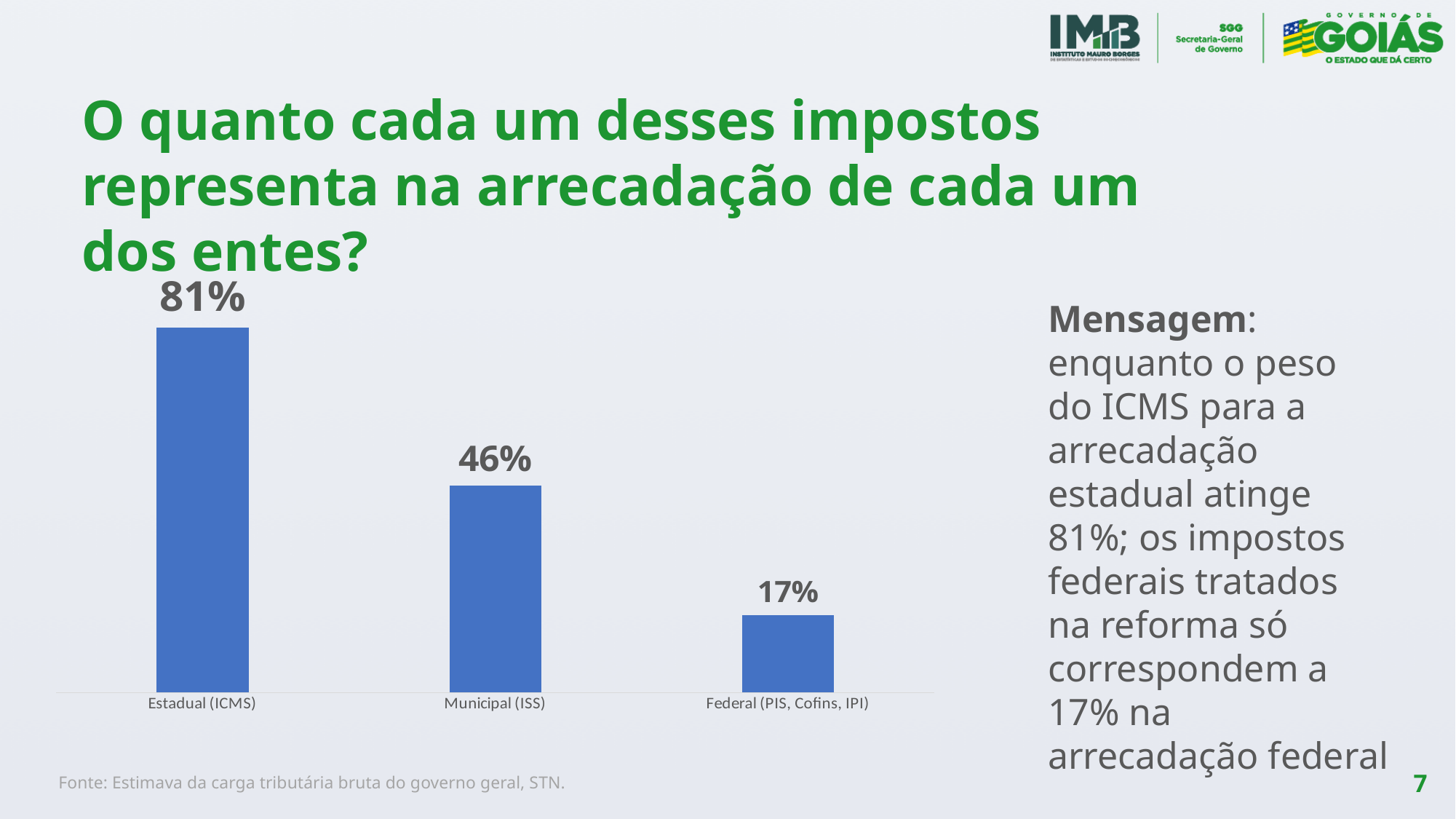
What is the value for Municipal (ISS)? 46% Do the values rise or fall from left to right across the categories? Fall What is the difference between the values for Estadual (ICMS) and Municipal (ISS)? 35% What is the value for Federal (PIS, Cofins, IPI)? 17% Which is larger, the value for Municipal (ISS) or the value for Federal (PIS, Cofins, IPI)? Municipal (ISS) What kind of chart is shown on the slide? Bar chart How many categories are shown in the chart? 3 What is the difference between the values for Municipal (ISS) and Federal (PIS, Cofins, IPI)? 29% Which category has the highest value? Estadual (ICMS) Which category has the lowest value? Federal (PIS, Cofins, IPI) What is the source cited below the chart? Estimava da carga tributária bruta do governo geral, STN. What is the value for Estadual (ICMS)? 81%